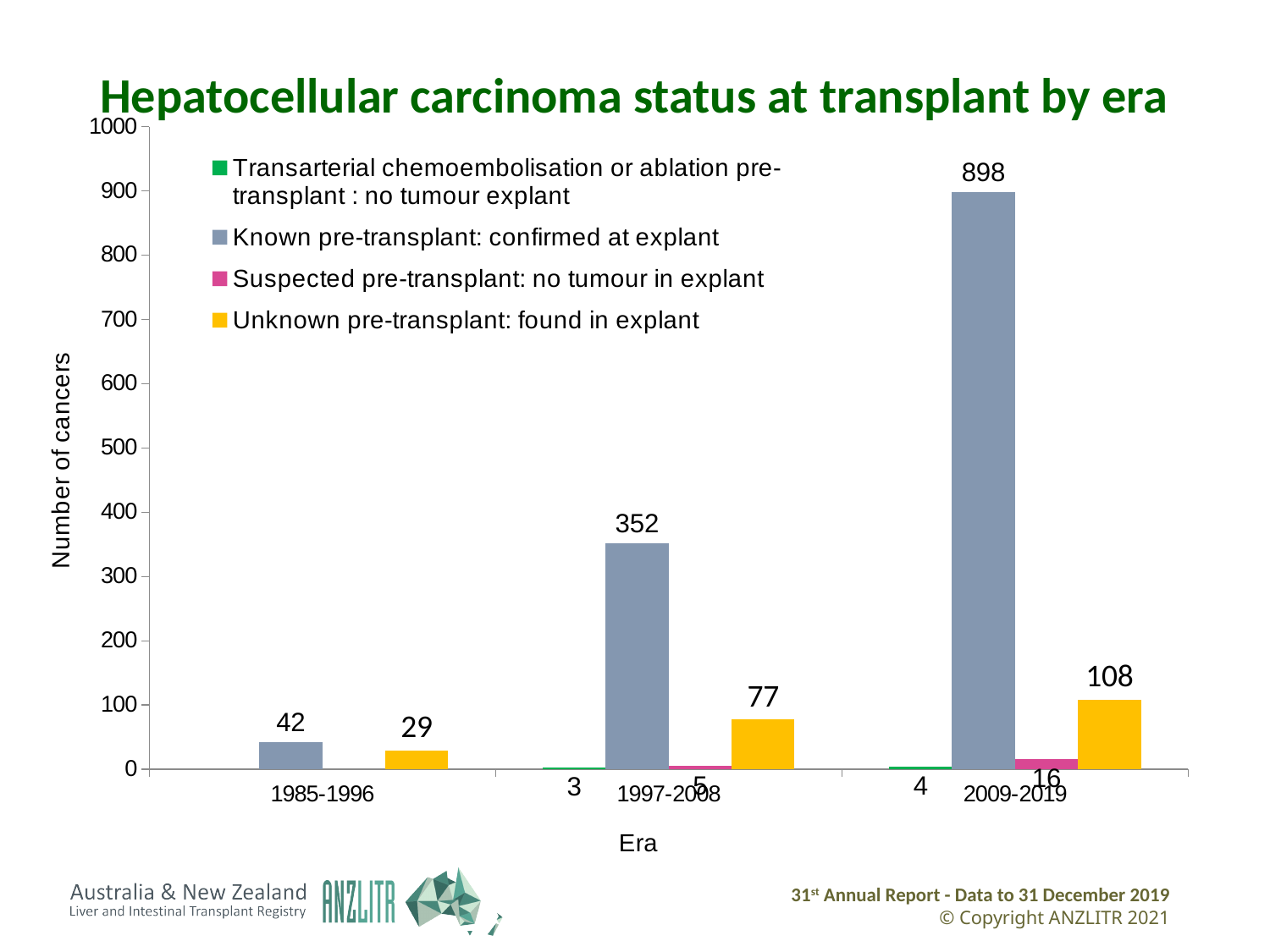
What is the difference between the 'Known pre-transplant: confirmed at explant' values for 2009-2019 and 1997-2008? 546 Which era has the highest value for 'Known pre-transplant: confirmed at explant'? 2009-2019 Which is larger in the 1997-2008 era: 'Known pre-transplant: confirmed at explant' or 'Unknown pre-transplant: found in explant'? Known pre-transplant: confirmed at explant What is the value for 'Unknown pre-transplant: found in explant' in the 1997-2008 era? 77 What is the value for 'Suspected pre-transplant: no tumour in explant' in the 2009-2019 era? 16 What is the value for 'Known pre-transplant: confirmed at explant' in the 2009-2019 era? 898 What is the value for 'Known pre-transplant: confirmed at explant' in the 1985-1996 era? 42 How many eras are shown on the x axis? 3 How many series does the legend list? 4 Which era has the lowest value for 'Unknown pre-transplant: found in explant'? 1985-1996 What kind of chart is shown on the slide? Bar chart What is the label of the y axis? Number of cancers